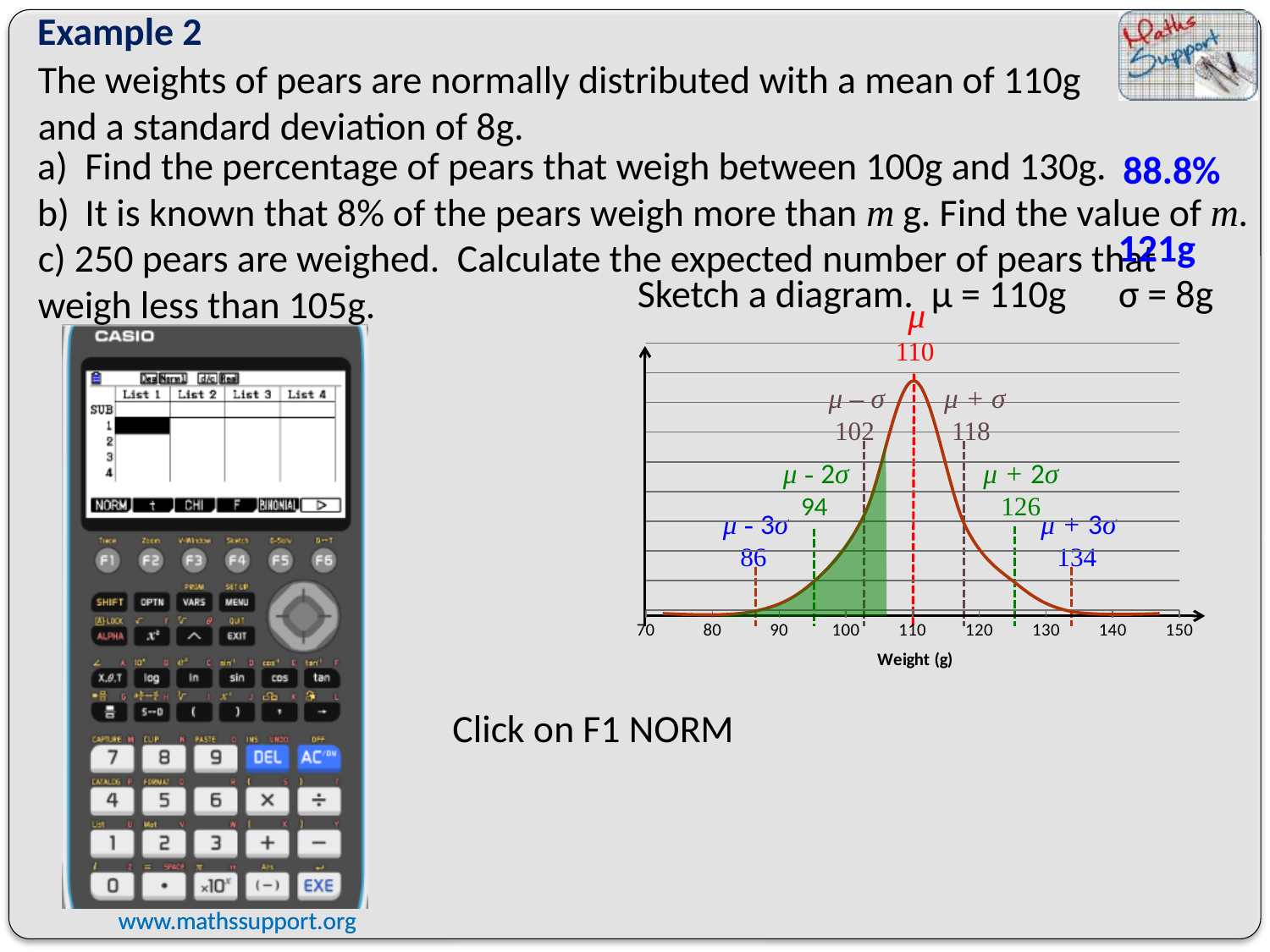
What is the difference between the values labelled at μ + 3σ and μ − 3σ on the sketch? 48 Is the value labelled at μ − 2σ on the sketch greater or less than 100? less What value is labelled at μ − σ on the normal distribution sketch? 102 What is the label on the horizontal axis of the normal distribution sketch? Weight (g) Which is larger on the sketch, the value labelled at μ + 2σ or the value labelled at μ − 2σ? μ + 2σ What is the lowest value shown on the horizontal axis of the normal distribution sketch? 70 What is the difference between the values labelled at μ + σ and μ − σ on the sketch? 16 What value is labelled at μ − 3σ on the normal distribution sketch? 86 What value is labelled at μ + 3σ on the normal distribution sketch? 134 What value is labelled at μ + 2σ on the normal distribution sketch? 126 What value is labelled at μ + σ on the normal distribution sketch? 118 What value is labelled at the mean μ on the normal distribution sketch? 110